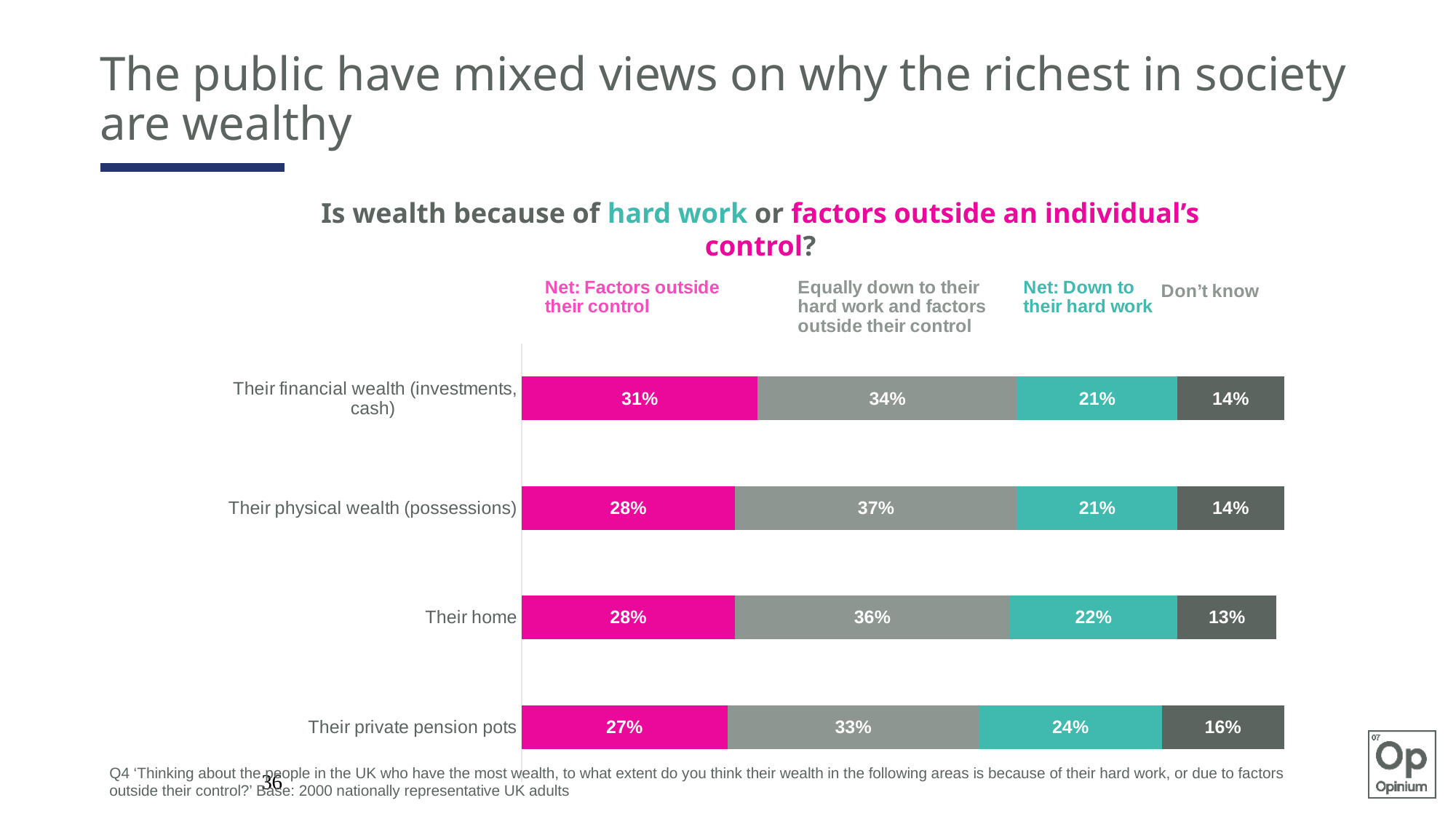
What is the 'Don't know' value for their private pension pots? 16% What percentage say their financial wealth (investments, cash) is due to 'Net: Factors outside their control'? 31% What is the total of the stacked bar for 'Their home'? 99% Which category has the highest value for 'Net: Factors outside their control'? Their financial wealth (investments, cash) Which category has the lowest 'Don't know' value? Their home How many categories are shown in the chart? 4 For their financial wealth (investments, cash), what is the difference between the 'Equally down to...' value and the 'Net: Down to their hard work' value? 13 percentage points Which category has the highest value for 'Equally down to their hard work and factors outside their control'? Their physical wealth (possessions) What type of chart is shown on the slide? Stacked bar chart Which has a larger 'Net: Down to their hard work' value: their private pension pots or their home? Their private pension pots What percentage say their home is 'Equally down to their hard work and factors outside their control'? 36% How many series does the chart legend list? 4